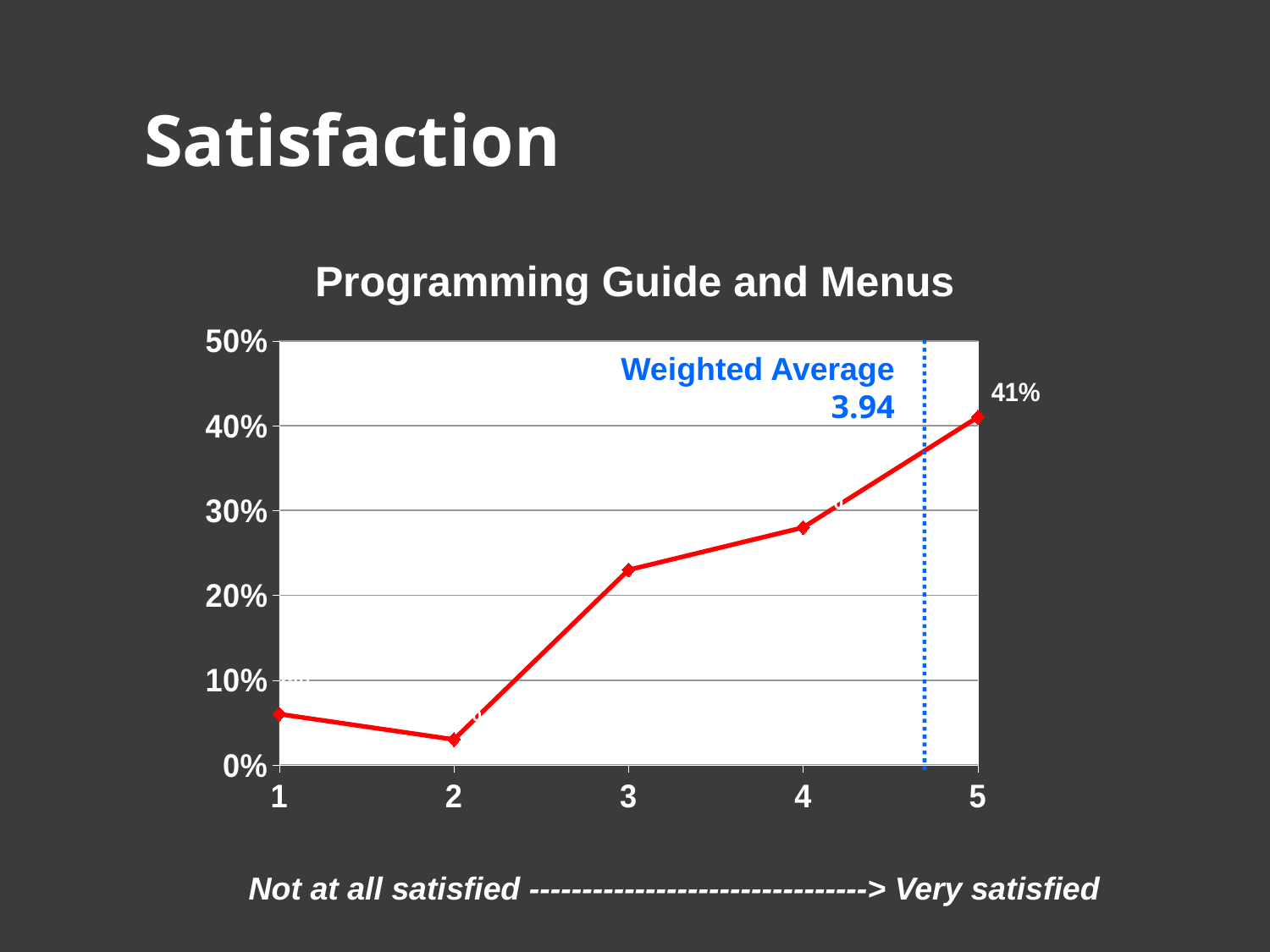
How many data points are plotted in the Programming Guide and Menus chart? 5 Which is larger, the value for category 3 or the value for category 2? 3 Is the value for category 3 greater or less than 20%? greater Is the value for category 4 greater or less than 30%? less What weighted average is shown on the chart? 3.94 What kind of chart is shown on the slide? line chart Is the value for category 1 greater or less than 10%? less Do the values generally rise or fall from category 1 to category 5? rise What is the value for category 5 in the Programming Guide and Menus chart? 41% Which category has the lowest value in the Programming Guide and Menus chart? 2 What is the title of the chart? Programming Guide and Menus Which category has the highest value in the Programming Guide and Menus chart? 5